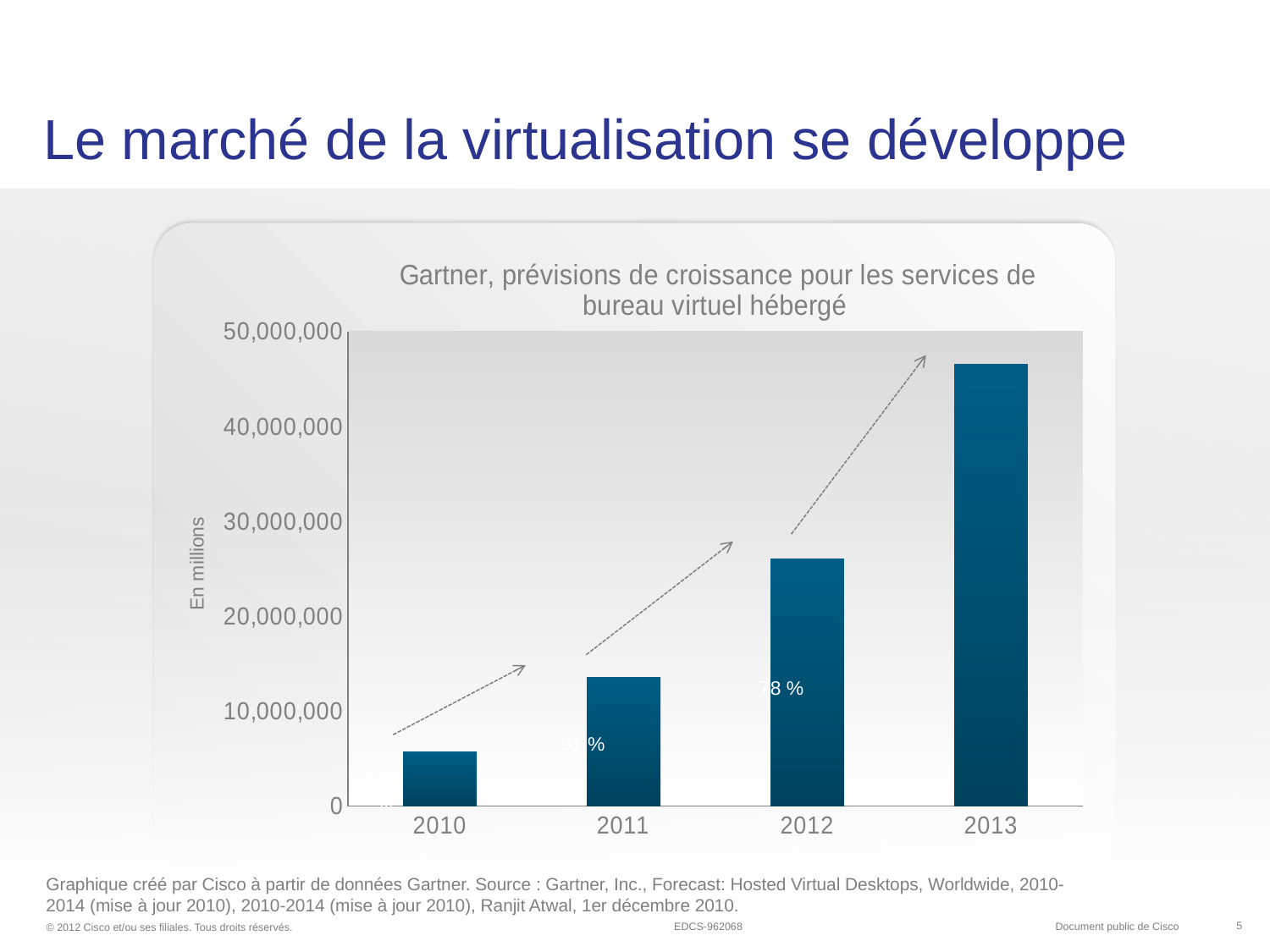
Is the value for 2010 greater or less than 10,000,000? less What is the label on the vertical axis of the chart? En millions Is the value for 2013 greater or less than 50,000,000? less Do the values rise or fall from 2010 to 2013? rise Is the value for 2012 greater or less than 20,000,000? greater Which year has the highest bar in the chart? 2013 Which is larger, the value for 2011 or the value for 2012? 2012 How many years are plotted on the x axis of the chart? 4 What kind of chart is shown on the slide? bar chart Which year has the lowest bar in the chart? 2010